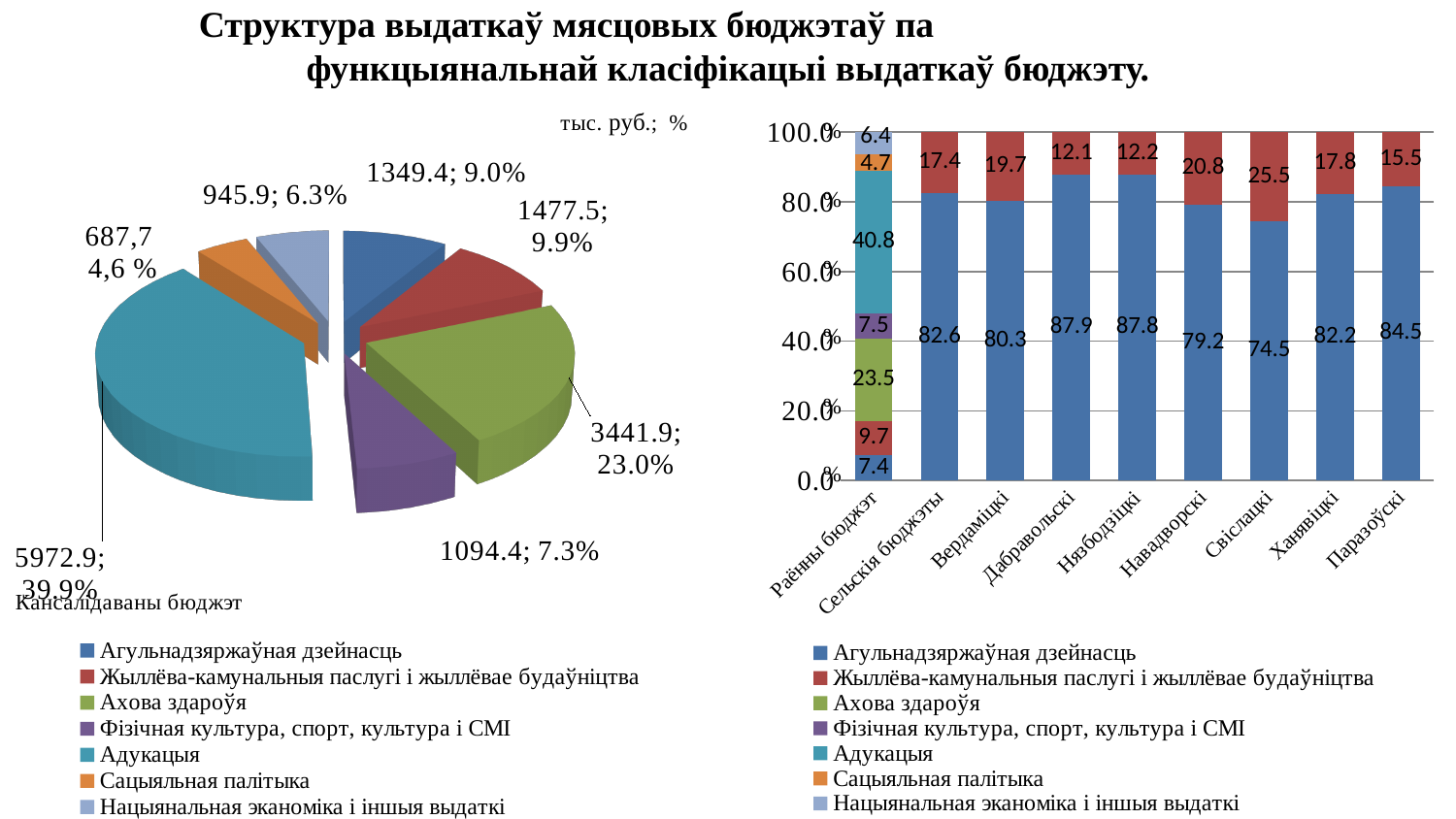
On the pie chart on the left, which category has the smallest slice? Сацыяльная палітыка On the stacked bar chart on the right, what is the value of Адукацыя for Раённы бюджэт? 40.8 On the stacked bar chart on the right, what is the value of Агульнадзяржаўная дзейнасць for Свіслацкі? 74.5 On the stacked bar chart on the right, which category has the highest value for Жыллёва-камунальныя паслугі і жыллёвае будаўніцтва? Свіслацкі On the stacked bar chart on the right, how many categories are shown on the x axis? 9 On the pie chart on the left, which category has the largest slice? Адукацыя What type of chart is shown on the right side of the slide? Stacked bar chart On the pie chart on the left, what share does the Ахова здароўя slice have? 23.0% On the pie chart on the left, how many slices are there? 7 On the stacked bar chart on the right, which is larger: the Агульнадзяржаўная дзейнасць value for Паразоўскі or for Ханявіцкі? Паразоўскі On the pie chart on the left, what value is shown for the Адукацыя slice? 5972.9; 39.9% On the stacked bar chart on the right, what is the difference between the Агульнадзяржаўная дзейнасць values for Дабравольскі and Навадворскі? 8.7